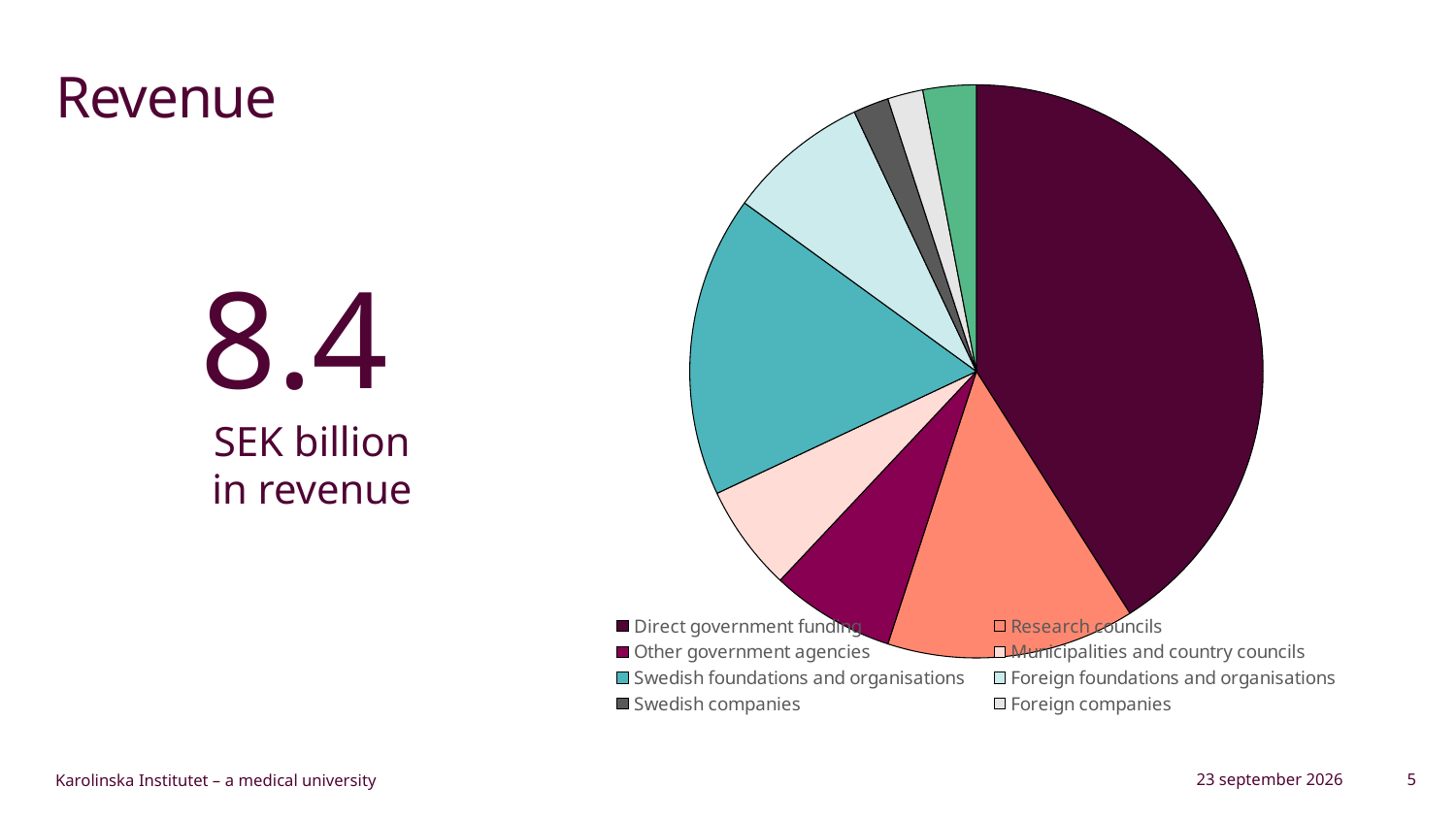
Which is larger, the slice for Research councils or the slice for Other government agencies? Research councils Which is larger, the slice for Swedish foundations and organisations or the slice for Swedish companies? Swedish foundations and organisations What is the title of the chart slide? Revenue How many entries does the legend list? 8 Which category has the largest slice of the pie? Direct government funding What kind of chart is shown on the slide? Pie chart Which is larger, the slice for Direct government funding or the slice for Research councils? Direct government funding What colour is the slice for Direct government funding? Dark purple